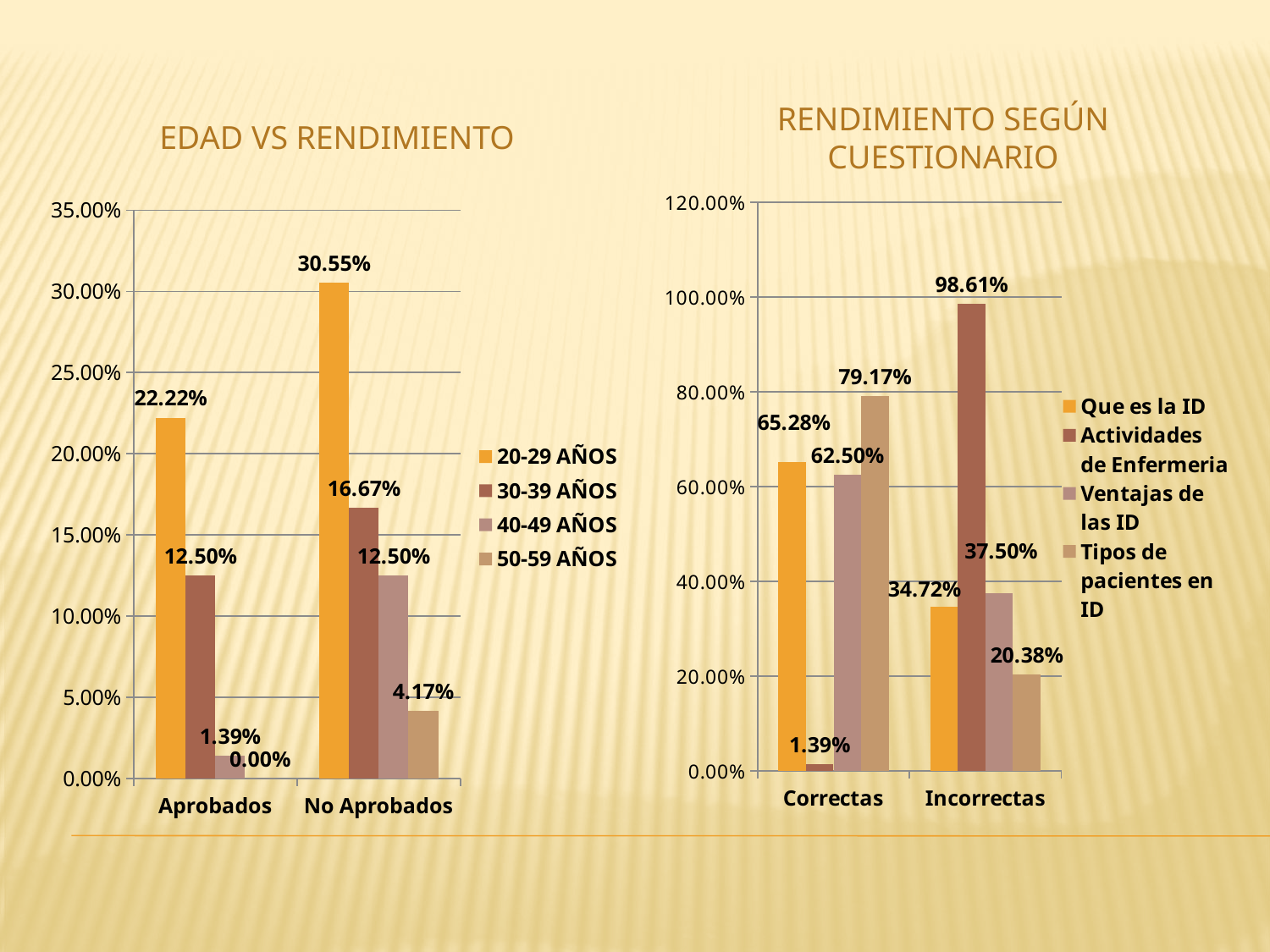
In the EDAD VS RENDIMIENTO chart, what is the difference between the 20-29 AÑOS values for No Aprobados and Aprobados? 8.33% In the EDAD VS RENDIMIENTO chart, is the value for 30-39 AÑOS in No Aprobados greater or less than 15.00%? greater In the RENDIMIENTO SEGÚN CUESTIONARIO chart, which series has the lowest value in the Correctas category? Actividades de Enfermeria In the EDAD VS RENDIMIENTO chart, what is the value for 20-29 AÑOS in the No Aprobados category? 30.55% In the RENDIMIENTO SEGÚN CUESTIONARIO chart, what is the difference between the Tipos de pacientes en ID values for Correctas and Incorrectas? 58.79% In the RENDIMIENTO SEGÚN CUESTIONARIO chart, which is larger: Que es la ID for Correctas or Ventajas de las ID for Correctas? Que es la ID for Correctas In the EDAD VS RENDIMIENTO chart, what is the value for 50-59 AÑOS in the Aprobados category? 0.00% In the EDAD VS RENDIMIENTO chart, how many series does the legend list? 4 In the RENDIMIENTO SEGÚN CUESTIONARIO chart, what is the value for Actividades de Enfermeria in the Incorrectas category? 98.61% In the RENDIMIENTO SEGÚN CUESTIONARIO chart, which series has the highest value in the Correctas category? Tipos de pacientes en ID In the EDAD VS RENDIMIENTO chart, which age group has the highest value in the Aprobados category? 20-29 AÑOS What kind of chart is the RENDIMIENTO SEGÚN CUESTIONARIO chart? Bar chart